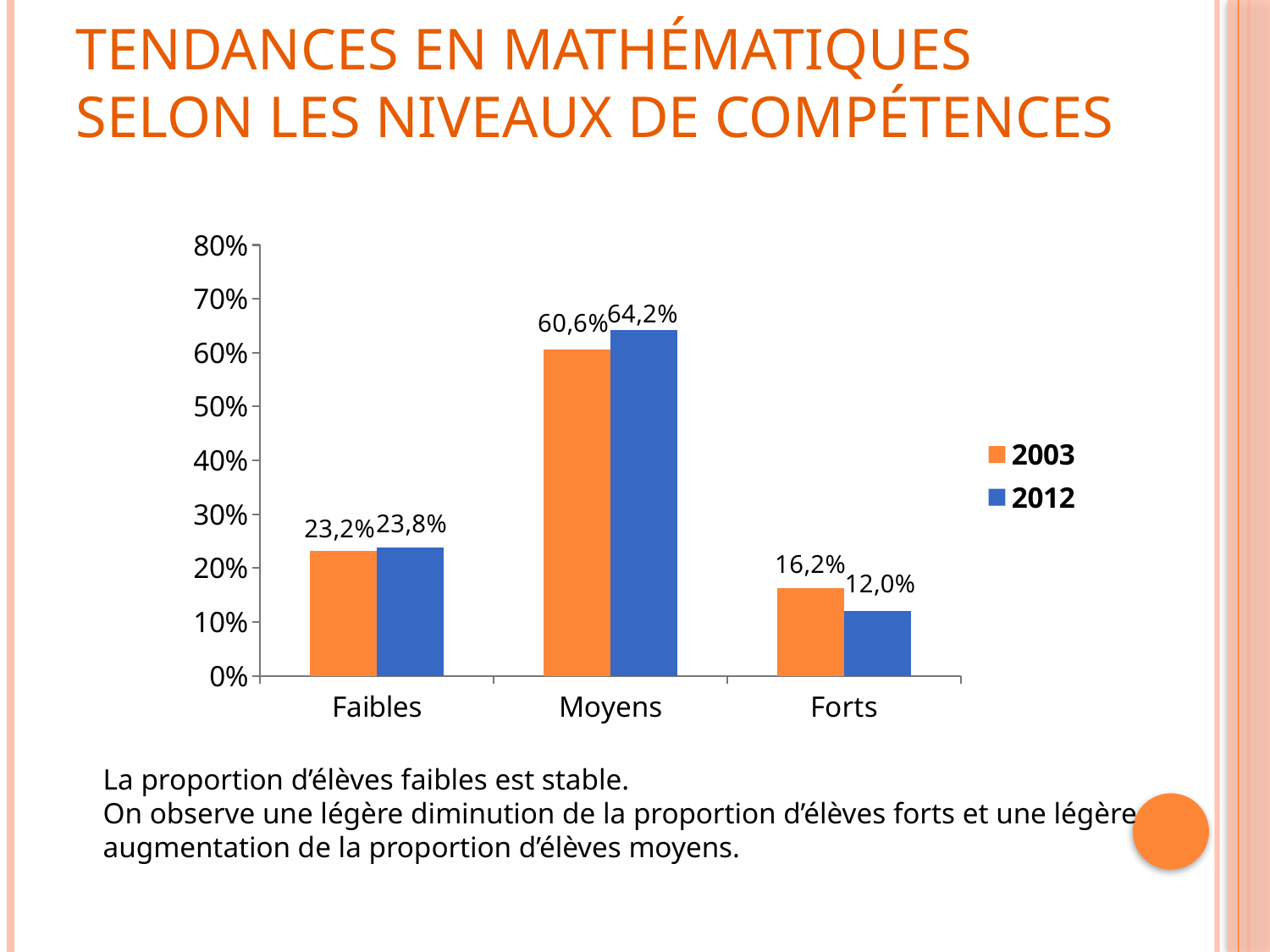
How many series does the legend list? 2 What is the value for Moyens in 2012? 64,2% Which category has the highest value in 2012? Moyens What is the difference between the 2003 and 2012 values for Forts? 4,2% What is the value for Faibles in 2003? 23,2% Which category has the lowest value in 2003? Forts What is the difference between the 2012 and 2003 values for Moyens? 3,6% How many categories are shown on the x axis? 3 What is the value for Forts in 2003? 16,2% Which is larger for Forts: the 2003 value or the 2012 value? 2003 What kind of chart is shown on the slide? bar chart Is the value for Moyens in 2003 greater or less than 50%? greater